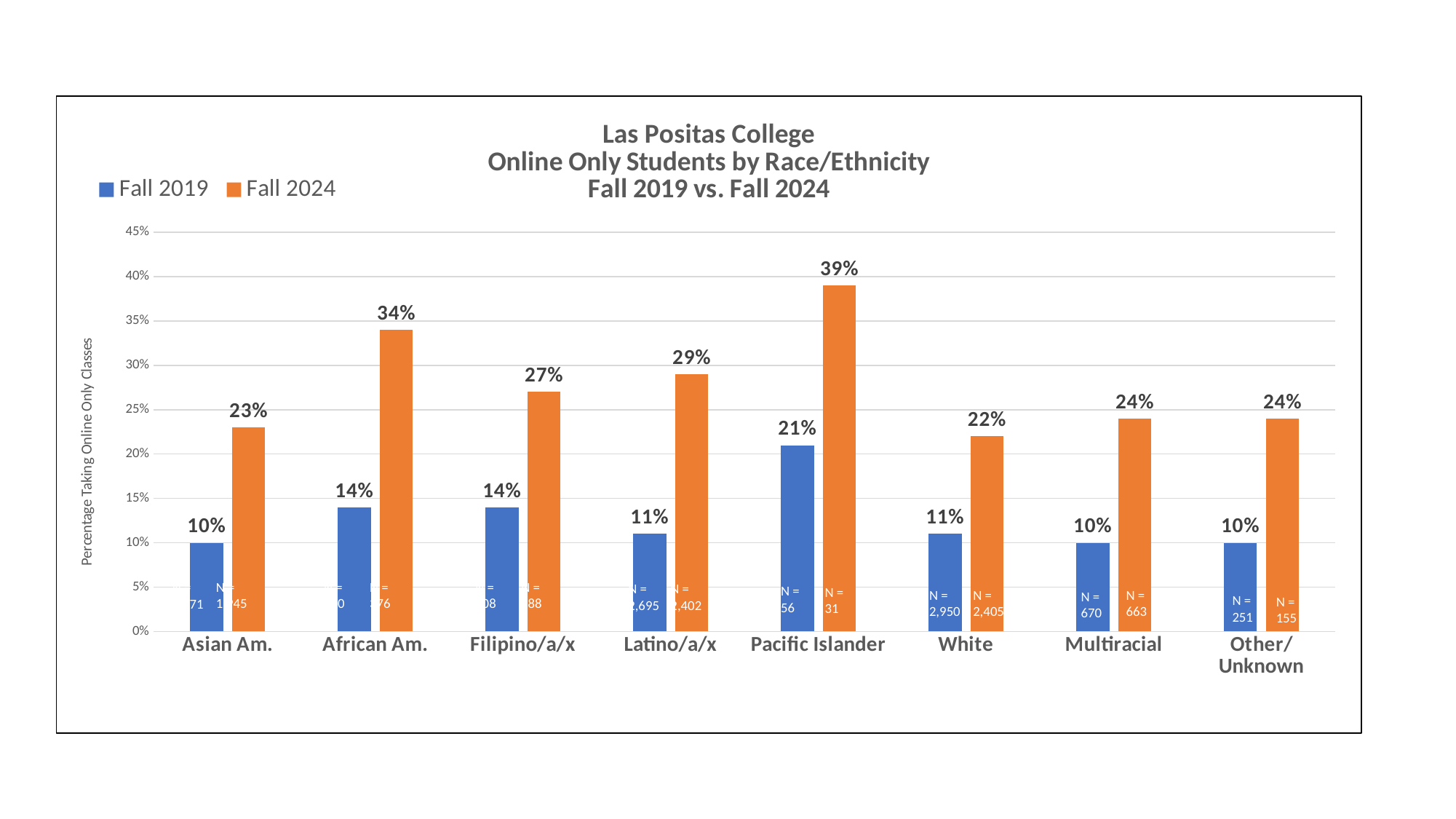
How many series does the legend list? 2 What is the difference between the Fall 2024 values for Pacific Islander and White? 17% How many race/ethnicity categories are shown on the x axis? 8 Which is larger, the Fall 2024 value for Filipino/a/x or the Fall 2024 value for Asian Am.? Filipino/a/x What is the Fall 2019 value for African Am.? 14% What is the difference between the Fall 2024 and Fall 2019 values for African Am.? 20% What is the Fall 2024 value for Pacific Islander? 39% What kind of chart is shown on the slide? Bar chart Which category has the highest Fall 2024 value? Pacific Islander Which category has the highest Fall 2019 value? Pacific Islander Which colour represents Fall 2024 in the legend? Orange What is the Fall 2024 value for Latino/a/x? 29%